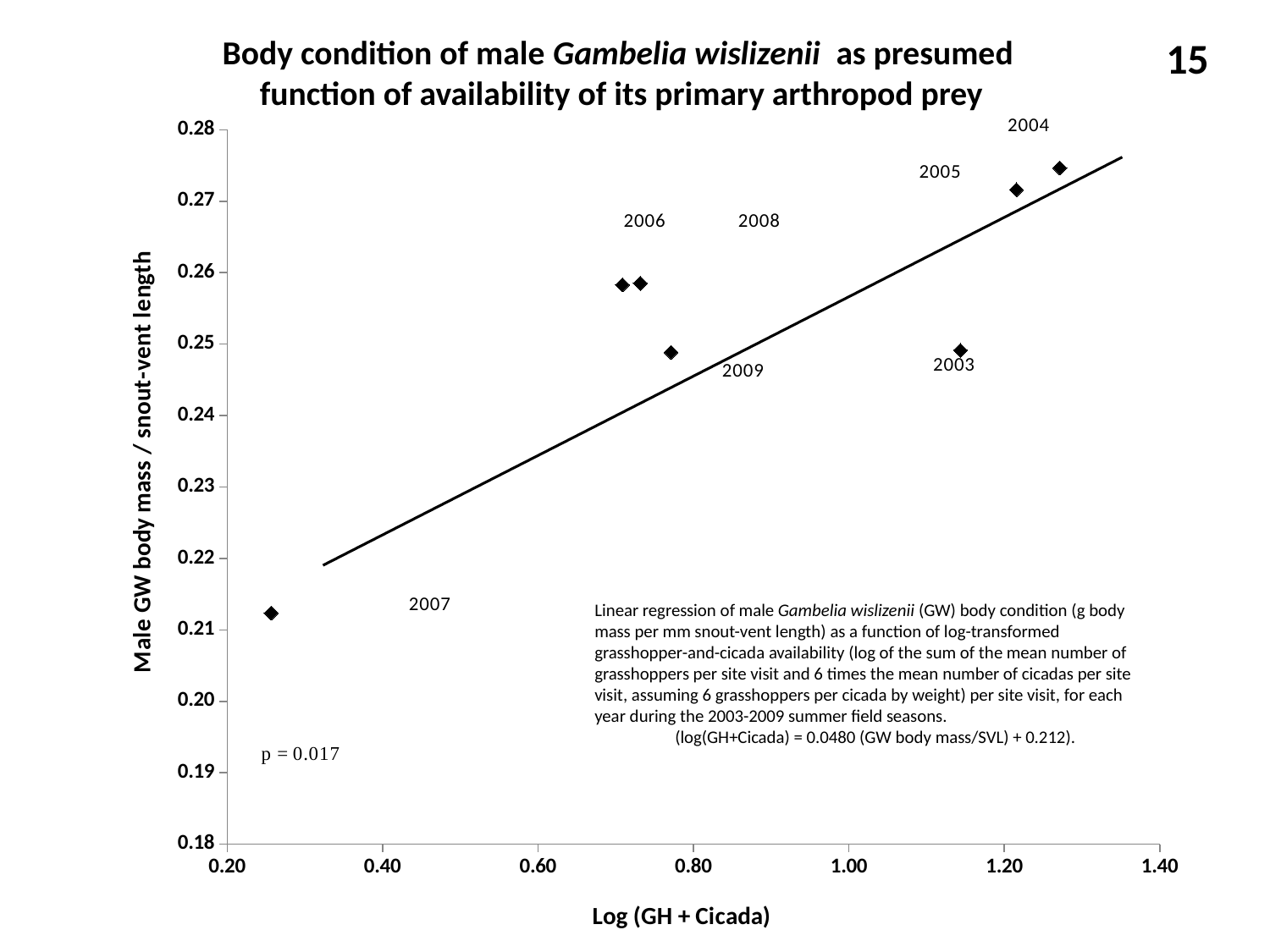
Is the body condition value for 2004 greater or less than 0.27? greater Which year has the highest male GW body condition value? 2004 Does male body condition generally rise or fall as Log (GH + Cicada) increases along the x axis? rise What is the p value shown on the chart? p = 0.017 Which year has the lowest Log (GH + Cicada) value? 2007 Is the Log (GH + Cicada) value for 2007 greater or less than 0.40? less How many data points are plotted on the chart? 7 Which year has a higher body condition value, 2004 or 2003? 2004 Is the Log (GH + Cicada) value for 2004 greater or less than 1.20? greater What kind of chart is shown on the slide? Scatter plot Which year has the lowest male GW body condition value? 2007